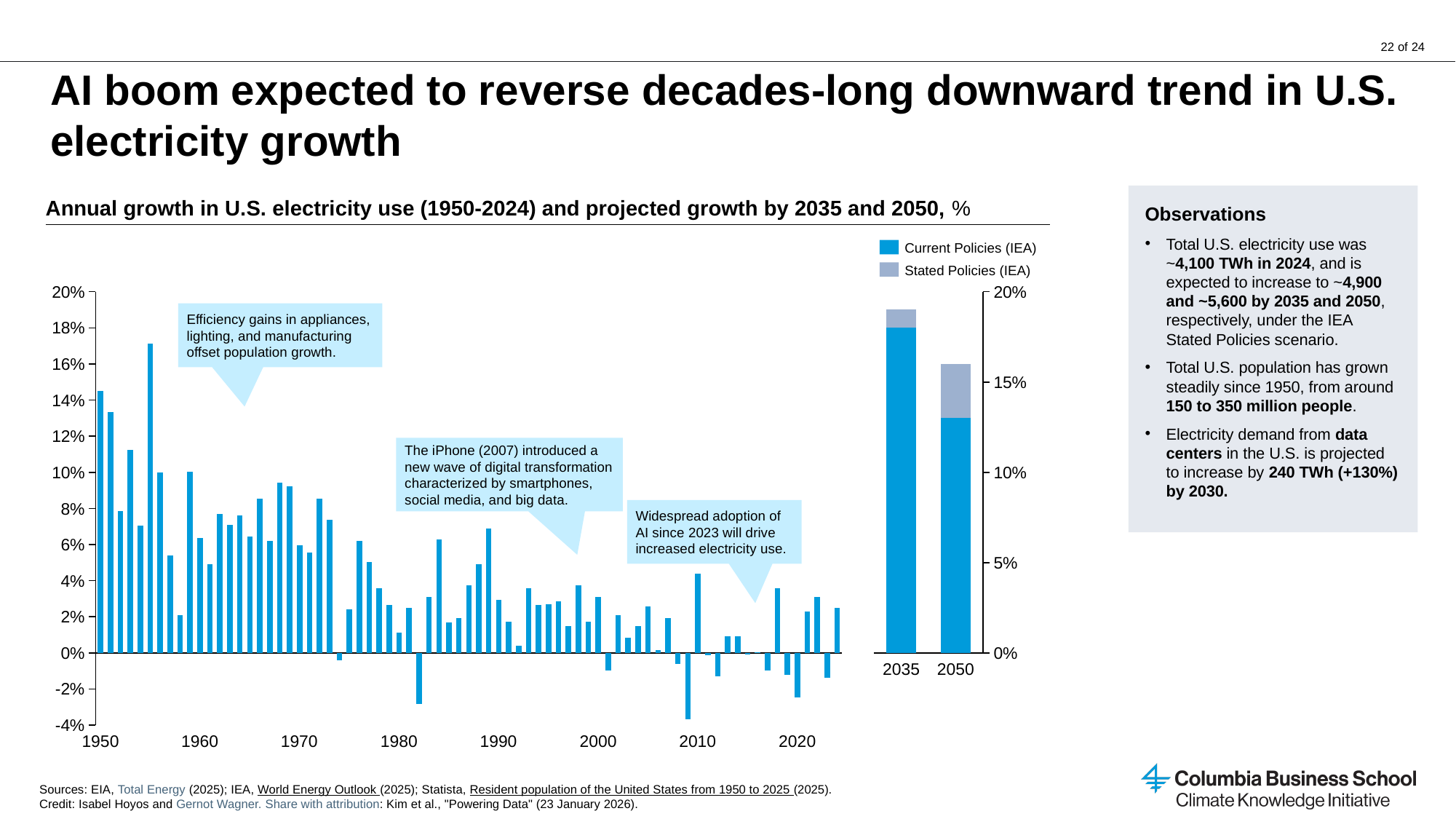
How many projection years are shown as stacked bars on the right-hand chart? 2 In the 1950-2024 chart, is the lowest bar (just before 2010) greater or less than -2%? less What kind of chart is used to show annual growth in U.S. electricity use from 1950 to 2024? Bar chart What are the two series named in the legend of the projected growth chart? Current Policies (IEA) and Stated Policies (IEA) What is the title of the chart on the slide? Annual growth in U.S. electricity use (1950-2024) and projected growth by 2035 and 2050, % In the projected growth chart, is the Current Policies (IEA) value for 2035 greater or less than 15%? greater In the 1950-2024 chart, is the tallest bar (in the mid-1950s) greater or less than 16%? greater How many series does the legend list for the projected growth chart (2035 and 2050)? 2 In the projected growth chart, which year has the taller stacked bar, 2035 or 2050? 2035 In the 1950-2024 chart, do annual growth values generally rise or fall from 1950 to 2024? Fall